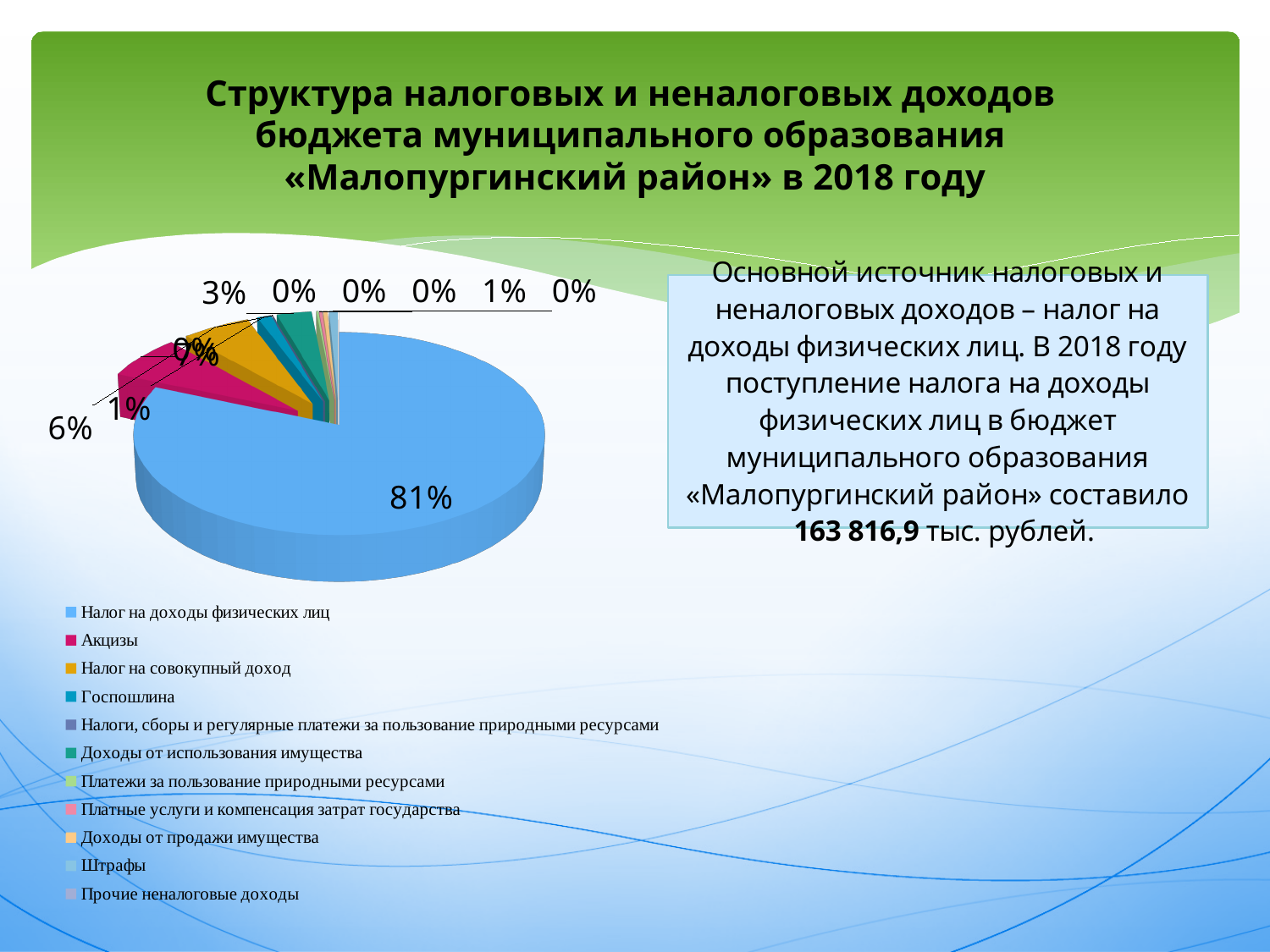
Which category has the largest share of the pie? Налог на доходы физических лиц According to the text box next to the chart, how much personal income tax was received into the budget in 2018? 163 816,9 тыс. рублей What is the title of the slide containing the pie chart? Структура налоговых и неналоговых доходов бюджета муниципального образования «Малопургинский район» в 2018 году Which colour represents Налог на доходы физических лиц in the pie chart? light blue Which is larger, the share for Налог на доходы физических лиц or the share for Акцизы? Налог на доходы физических лиц What share of the pie does Налог на доходы физических лиц have? 81% How many categories does the legend of the pie chart list? 11 What kind of chart is shown on the slide? pie chart